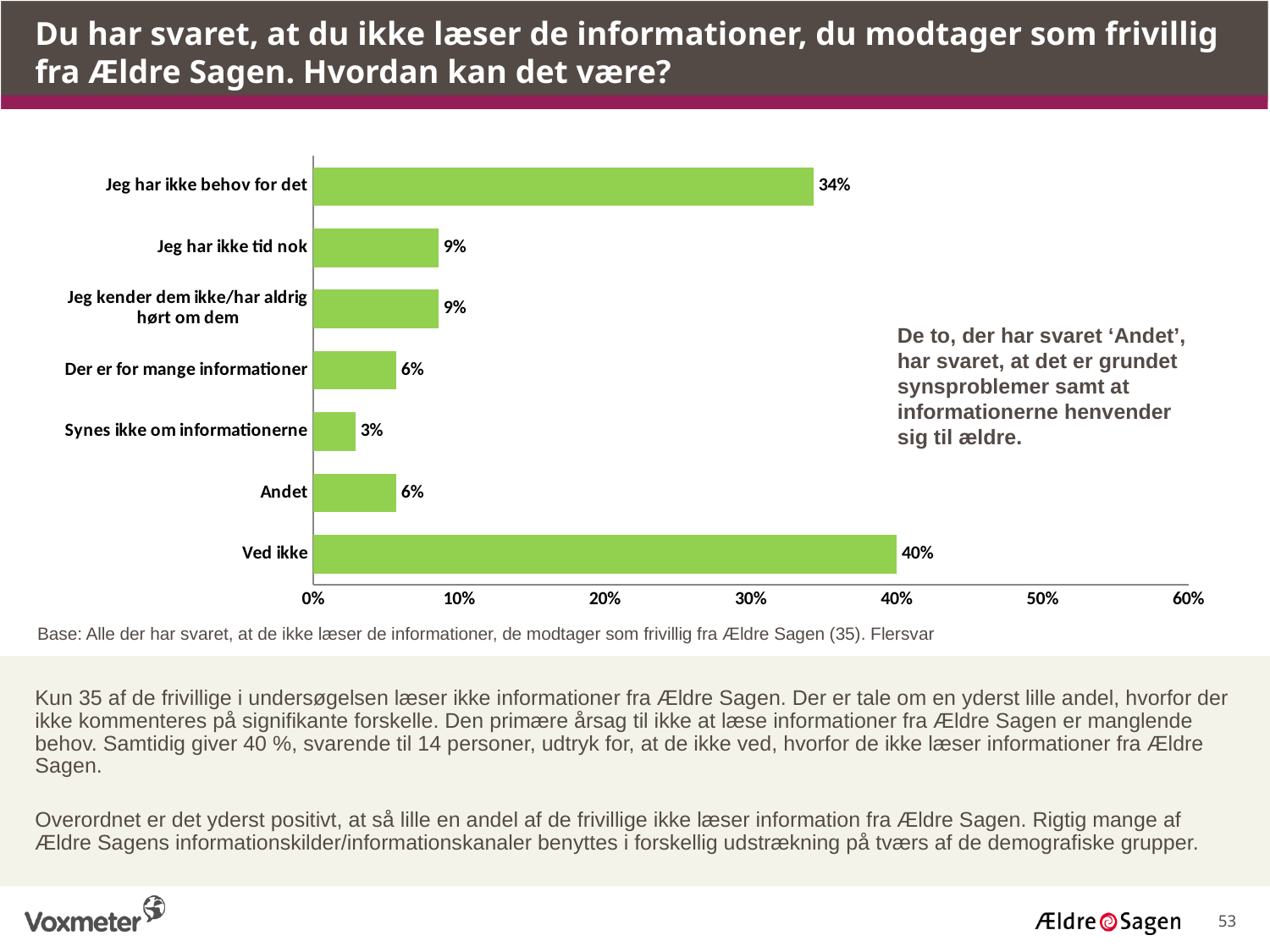
What kind of chart is shown on the slide? bar chart What is the value for "Jeg har ikke behov for det"? 34% How many categories are shown in the chart? 7 What is the value for "Synes ikke om informationerne"? 3% What is the value for "Der er for mange informationer"? 6% Which category has the highest value? Ved ikke What is the value for "Ved ikke"? 40% Which is larger, the value for "Jeg har ikke tid nok" or the value for "Andet"? Jeg har ikke tid nok What is the highest value shown on the x axis? 60% Is the value for "Jeg har ikke behov for det" greater or less than 30%? greater What is the difference between the values for "Ved ikke" and "Jeg har ikke behov for det"? 6% Which category has the lowest value? Synes ikke om informationerne